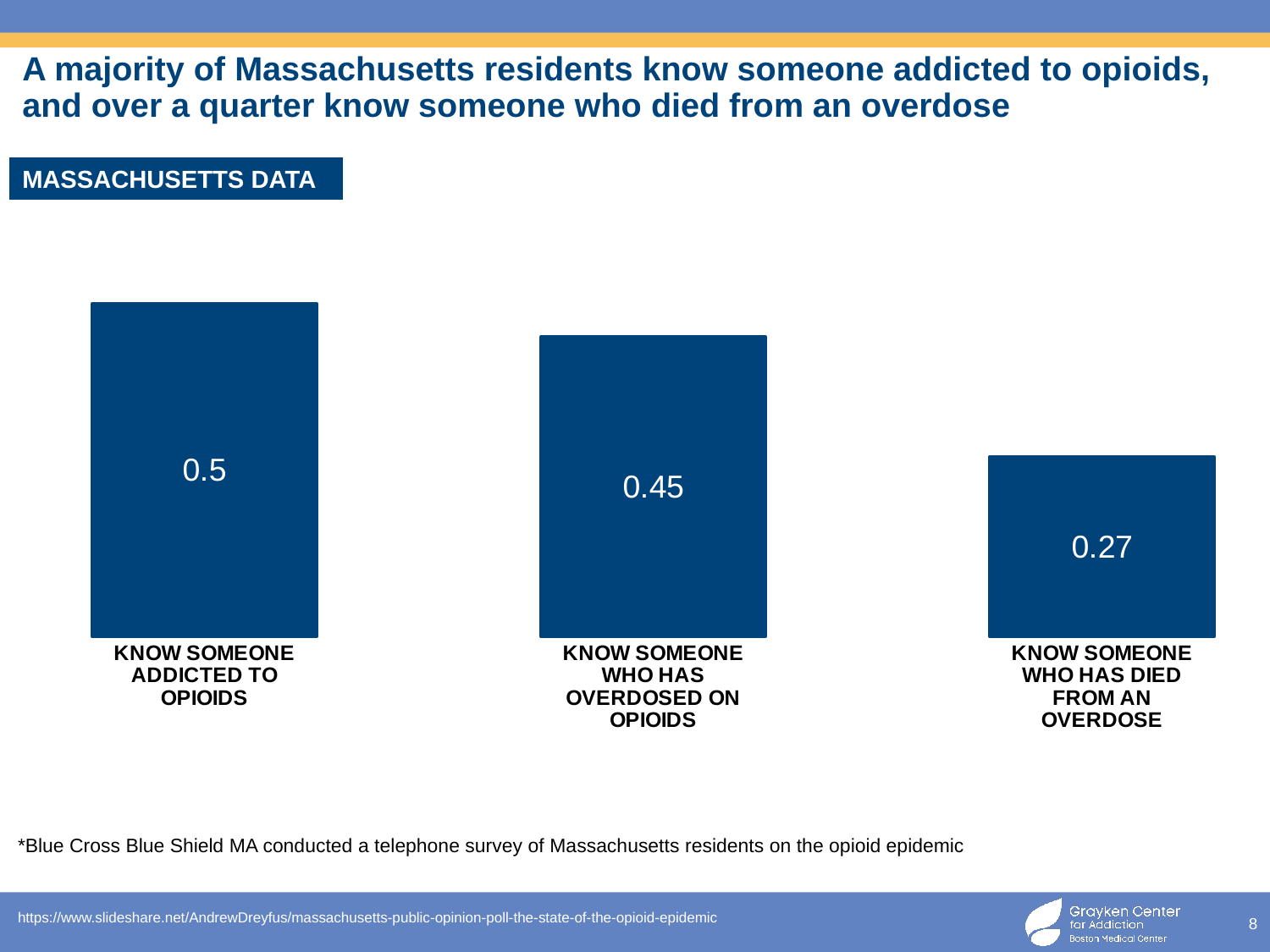
What is the value for 'Know someone who has died from an overdose'? 0.27 Do the values rise or fall from left to right across the categories? Fall What is the difference between the values for 'Know someone addicted to opioids' and 'Know someone who has died from an overdose'? 0.23 Which category has the lowest value? Know someone who has died from an overdose How many categories are shown in the chart? 3 What is the value for 'Know someone addicted to opioids'? 0.5 What kind of chart is shown on the slide? Bar chart Which is larger: the value for 'Know someone who has overdosed on opioids' or 'Know someone who has died from an overdose'? Know someone who has overdosed on opioids What is the difference between the values for 'Know someone addicted to opioids' and 'Know someone who has overdosed on opioids'? 0.05 What is the value for 'Know someone who has overdosed on opioids'? 0.45 What is the label shown in the box above the chart? MASSACHUSETTS DATA Which category has the highest value? Know someone addicted to opioids